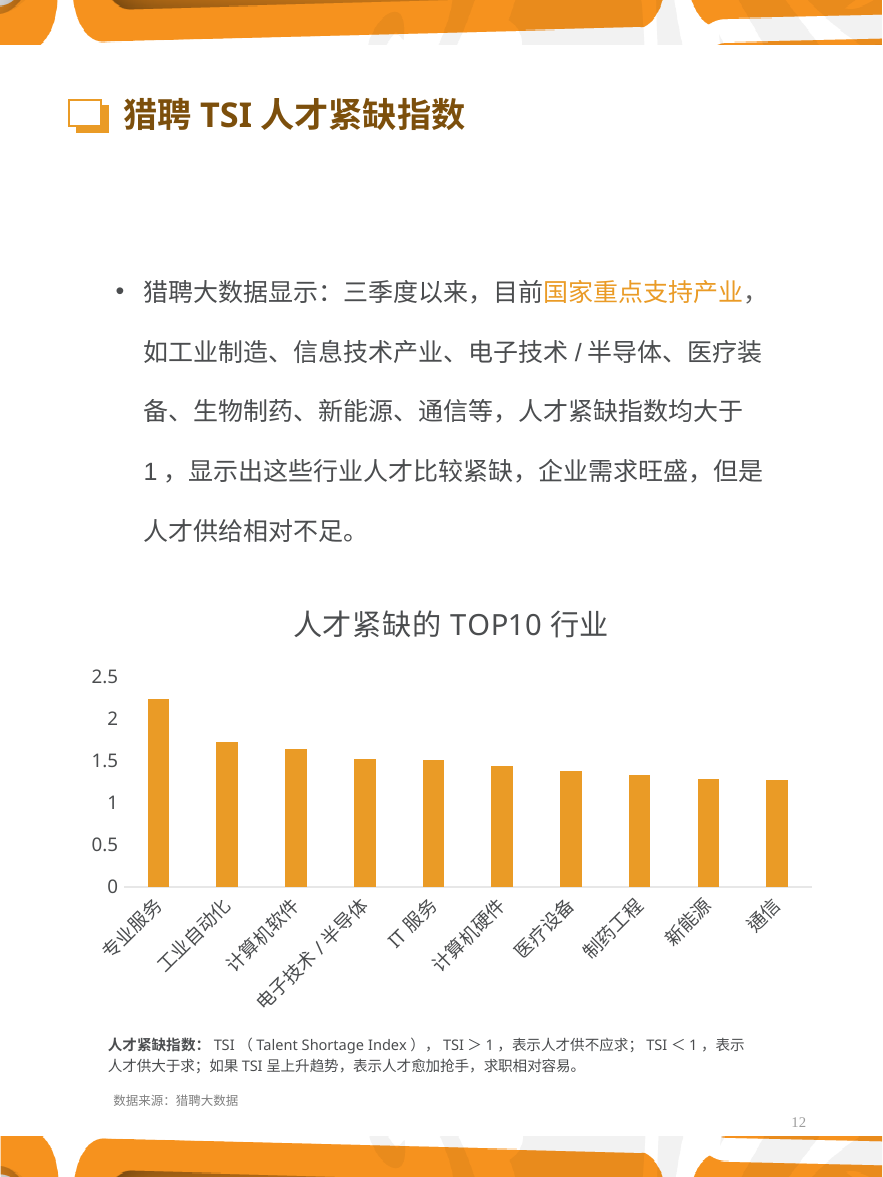
How many industries are plotted in the chart 人才紧缺的 TOP10 行业? 10 What is the title of the chart on the slide? 人才紧缺的 TOP10 行业 Is the value for 专业服务 greater or less than 2? greater Is the value for 通信 greater or less than 1? greater Which has a larger value, 工业自动化 or 制药工程? 工业自动化 Which industry has the highest value in the chart 人才紧缺的 TOP10 行业? 专业服务 What kind of chart is shown under the title 人才紧缺的 TOP10 行业? bar chart Do the values rise or fall from left to right along the x axis? fall Is the value for 新能源 greater or less than 1.5? less Which has a larger value, 专业服务 or 通信? 专业服务